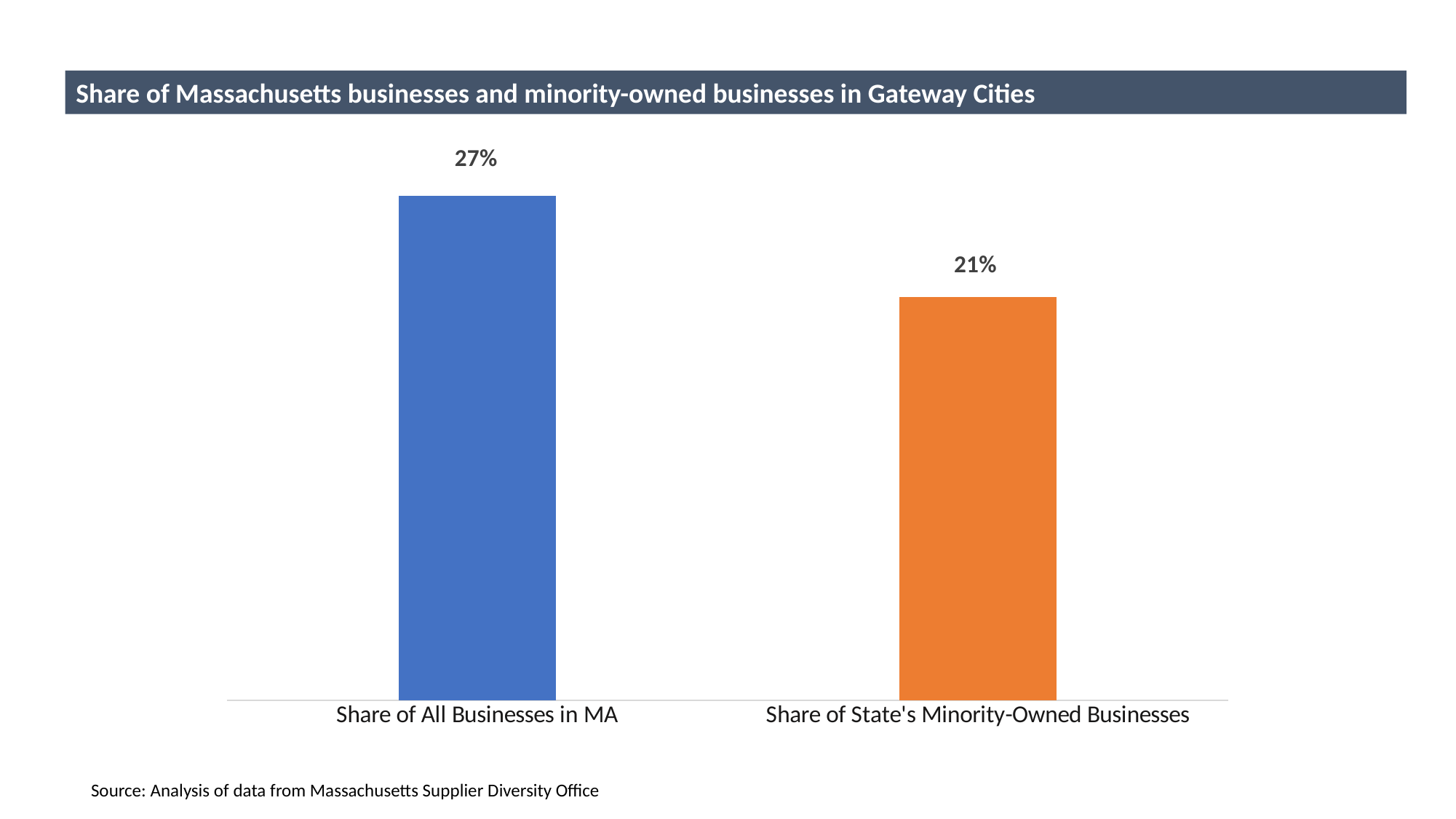
What is the difference between Share of All Businesses in MA and Share of State's Minority-Owned Businesses? 6% What kind of chart is shown on the slide? Bar chart Which category has the highest value? Share of All Businesses in MA Do the values rise or fall from left to right across the categories? Fall Which category has the lowest value? Share of State's Minority-Owned Businesses What is the value for Share of State's Minority-Owned Businesses? 21% What is the title of the chart? Share of Massachusetts businesses and minority-owned businesses in Gateway Cities What colour is the bar for Share of State's Minority-Owned Businesses? Orange What is the value for Share of All Businesses in MA? 27% Which is larger: Share of All Businesses in MA or Share of State's Minority-Owned Businesses? Share of All Businesses in MA How many categories are shown in the chart? 2